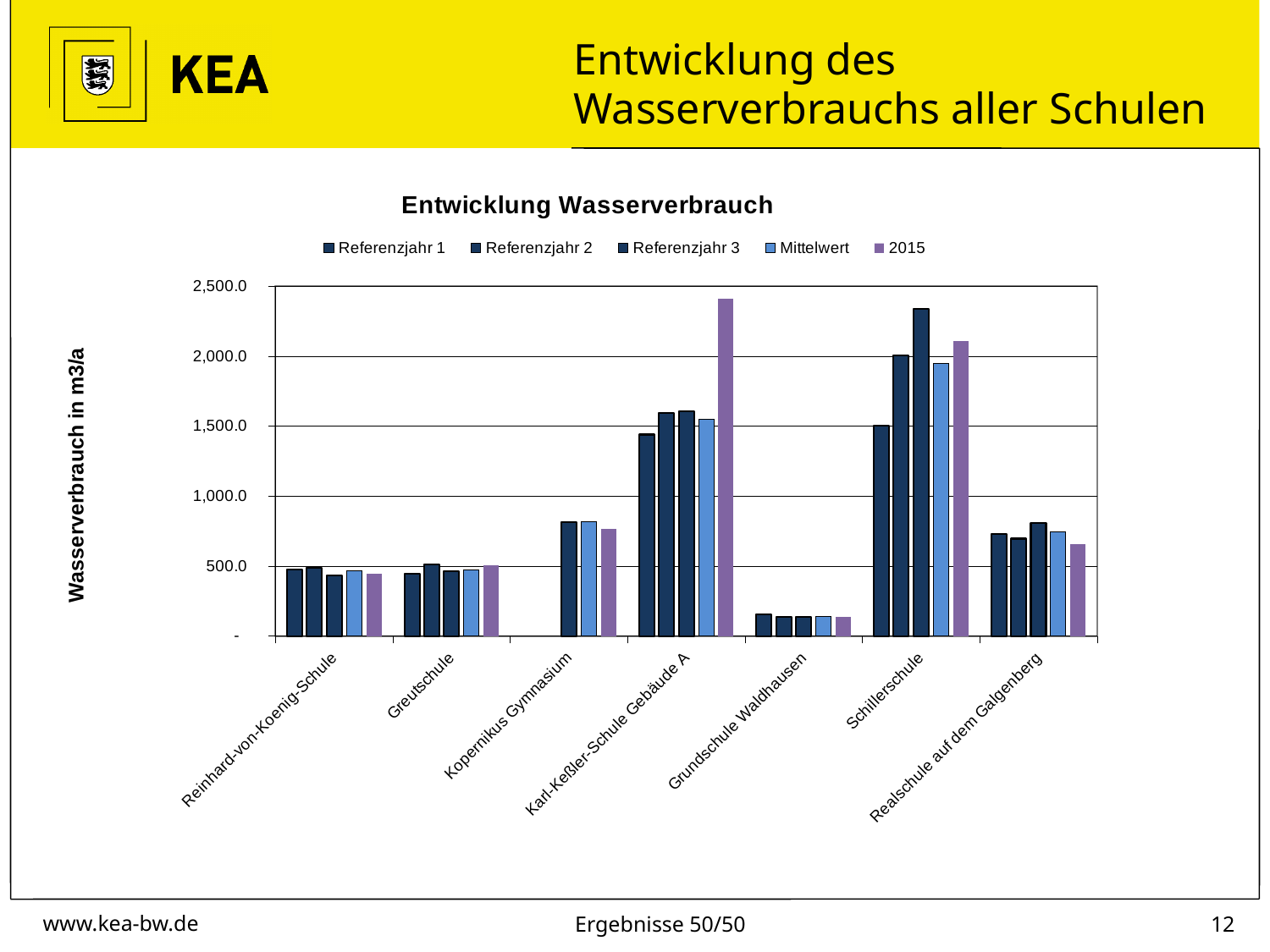
Is the Referenzjahr 3 value for Schillerschule greater or less than 2,000.0? greater Which school has the highest value for the 2015 series? Karl-Keßler-Schule Gebäude A Which is larger, the Mittelwert value for Kopernikus Gymnasium or the Mittelwert value for Greutschule? Kopernikus Gymnasium Which is larger, the 2015 value for Schillerschule or the 2015 value for Realschule auf dem Galgenberg? Schillerschule How many series does the legend list? 5 Is the Mittelwert value for Kopernikus Gymnasium greater or less than 1,000.0? less Is the 2015 value for Karl-Keßler-Schule Gebäude A greater or less than 2,000.0? greater Which school has the lowest value for the 2015 series? Grundschule Waldhausen How many schools (categories) are shown on the x axis? 7 What is the title of the y axis of the chart? Wasserverbrauch in m3/a What kind of chart is shown on the slide? bar chart